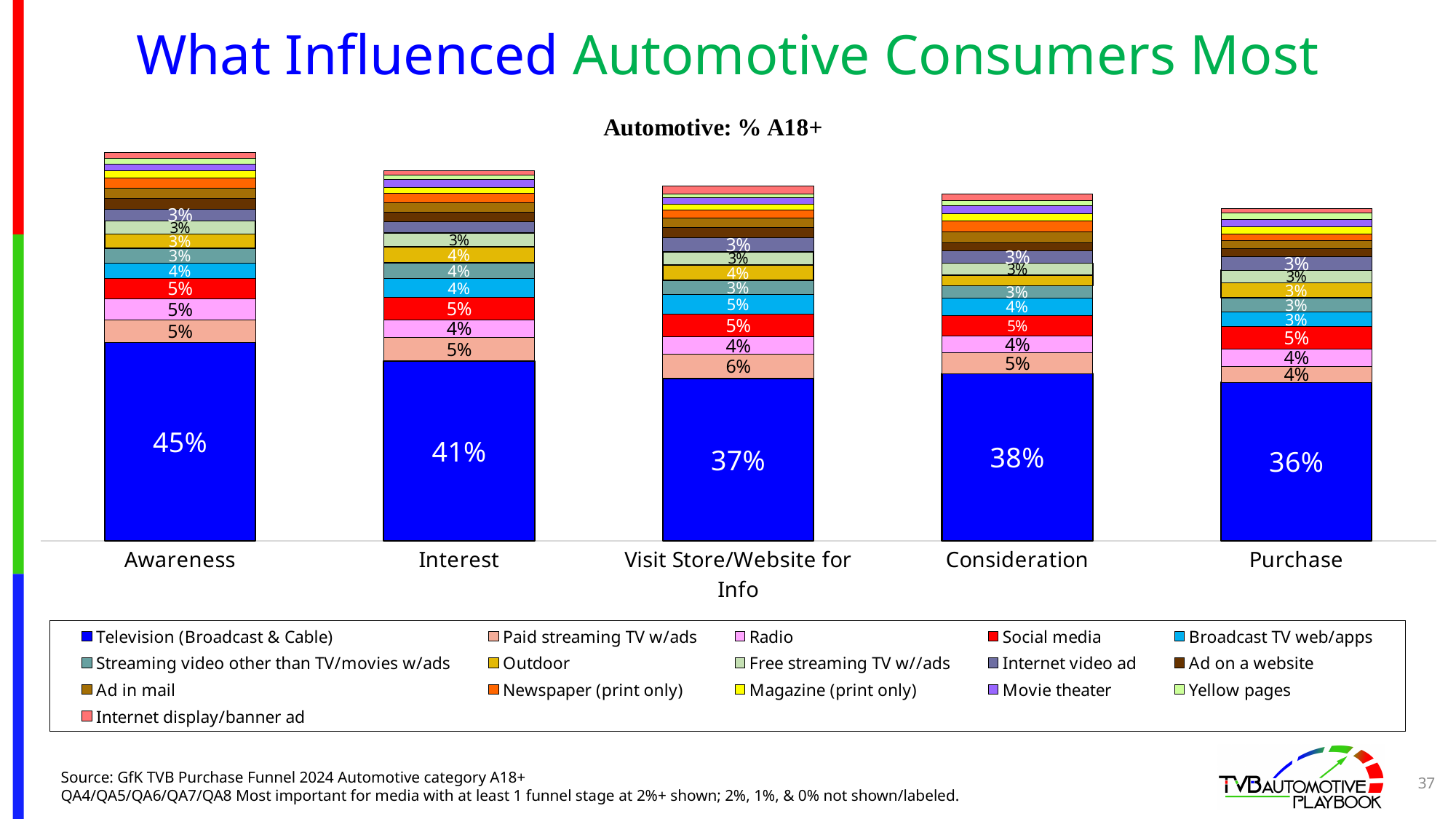
At which funnel stage is the Television (Broadcast & Cable) value lowest? Purchase What is the Television (Broadcast & Cable) value for Purchase? 36% Does the Television (Broadcast & Cable) value rise or fall from Awareness to Interest? Fall What is the Television (Broadcast & Cable) value for Awareness? 45% What is the Paid streaming TV w/ads value for Visit Store/Website for Info? 6% What is the difference between the Television (Broadcast & Cable) values for Awareness and Purchase? 9 percentage points How many series does the legend list? 16 How many funnel stages (categories) are shown along the x axis? 5 What is the subtitle printed above the chart? Automotive: % A18+ Which has the larger Television (Broadcast & Cable) value, Consideration or Visit Store/Website for Info? Consideration At which funnel stage is the Television (Broadcast & Cable) value highest? Awareness What kind of chart is shown on the slide? Stacked bar chart